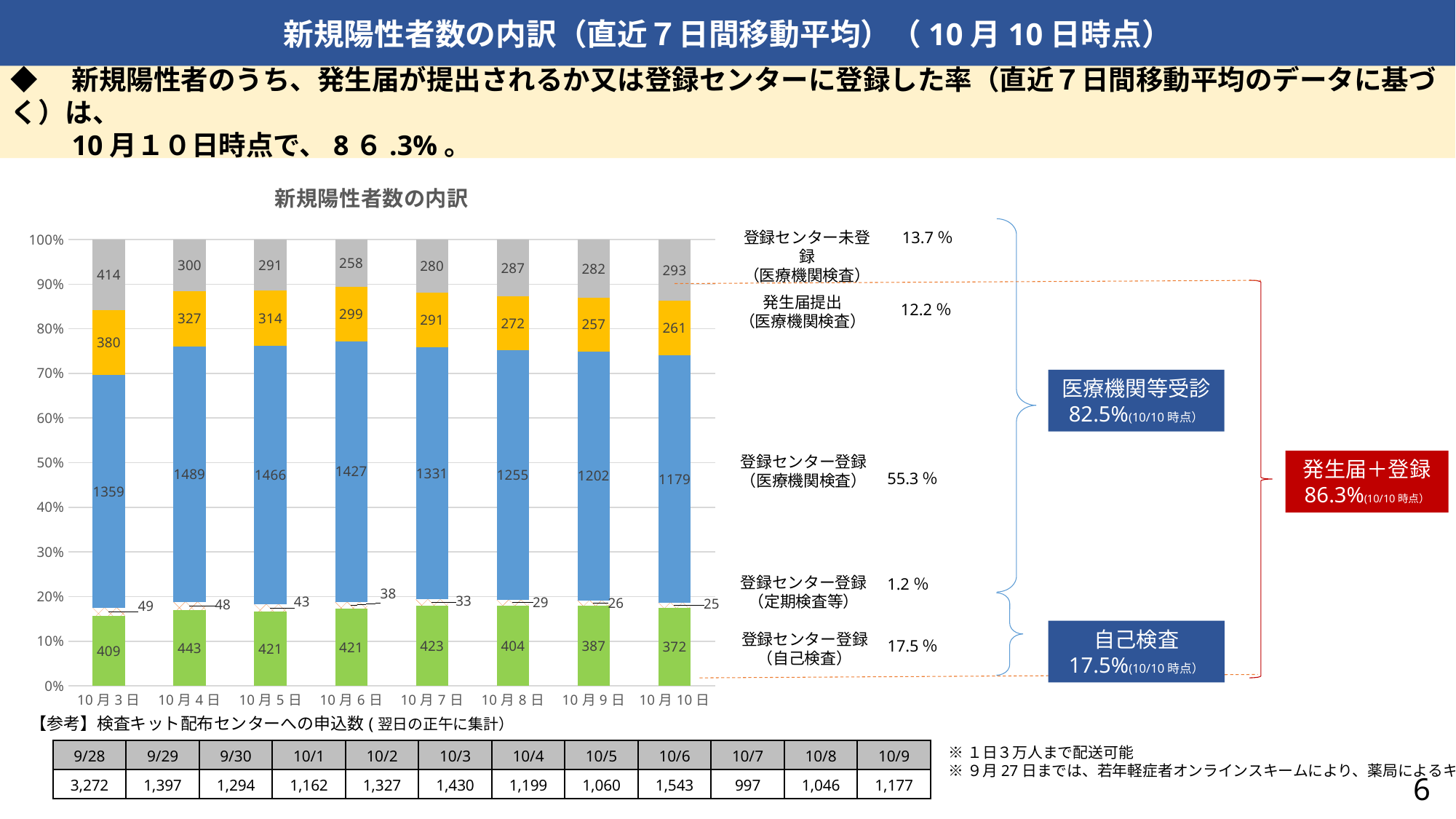
In the 新規陽性者数の内訳 chart, on which date is the blue segment (登録センター登録（医療機関検査）) value the highest? 10月4日 In the 新規陽性者数の内訳 chart, what is the value of the blue segment (登録センター登録（医療機関検査）) for 10月4日? 1489 In the 新規陽性者数の内訳 chart, what is the value of the gray top segment (登録センター未登録（医療機関検査）) for 10月3日? 414 What kind of chart is the 新規陽性者数の内訳 chart? Stacked bar chart What is the title of the stacked bar chart on the slide? 新規陽性者数の内訳 In the 新規陽性者数の内訳 chart, which date has the larger green segment (自己検査) value, 10月4日 or 10月5日? 10月4日 In the 新規陽性者数の内訳 chart, what is the total of all segments in the 10月10日 bar? 2130 In the 新規陽性者数の内訳 chart, what is the value of the green segment (登録センター登録（自己検査）) for 10月7日? 423 In the 新規陽性者数の内訳 chart, on which date is the green segment (登録センター登録（自己検査）) value the lowest? 10月10日 How many dates are shown on the x axis of the 新規陽性者数の内訳 chart? 8 In the 新規陽性者数の内訳 chart, what is the difference between the orange segment (発生届提出) values for 10月3日 and 10月10日? 119 In the 新規陽性者数の内訳 chart, do the values of the small segment labelled 登録センター登録（定期検査等） rise or fall from 10月3日 to 10月10日? Fall